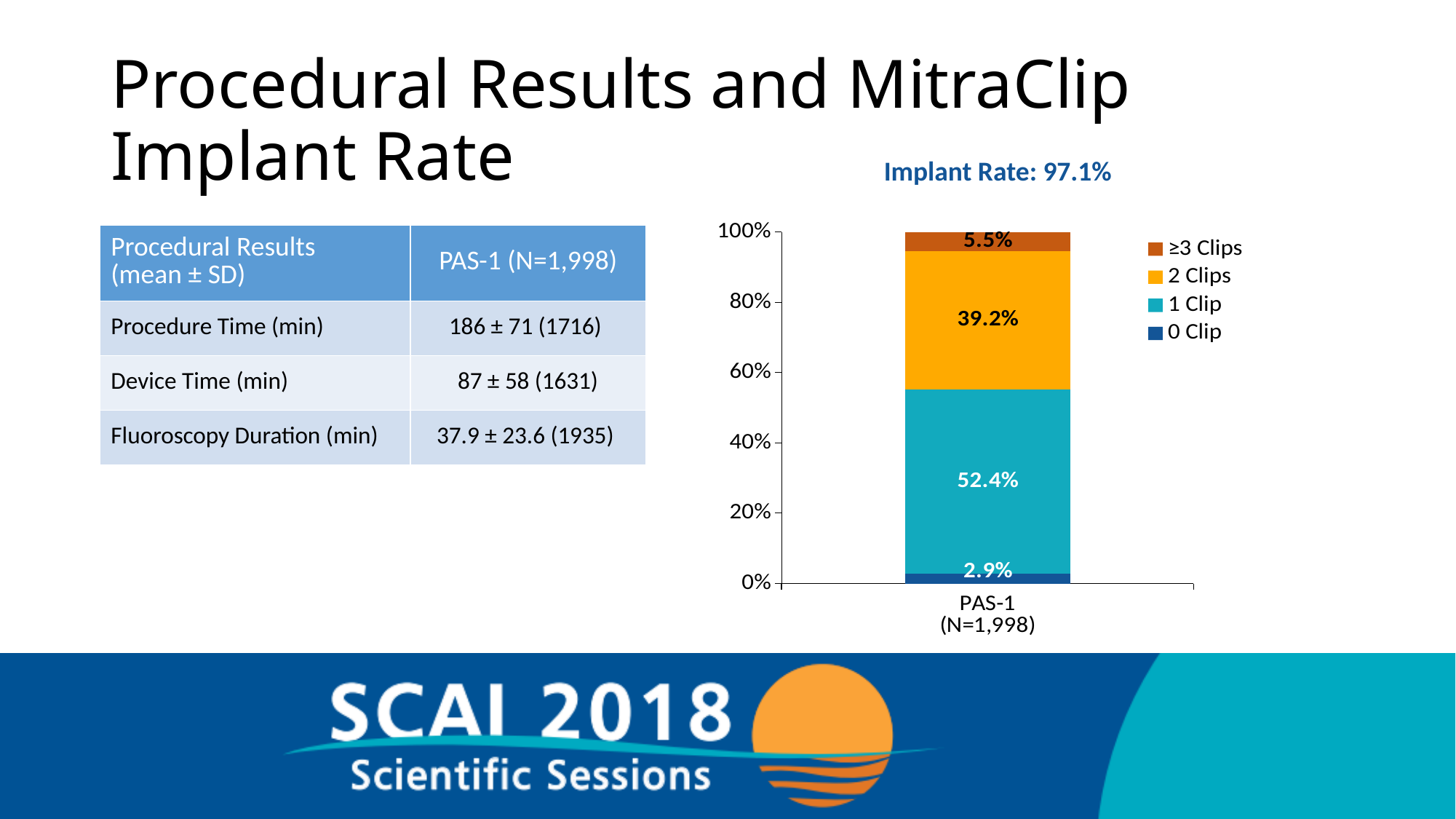
What percentage of the PAS-1 bar corresponds to 1 Clip? 52.4% Which clip category has the smallest share of the PAS-1 bar? 0 Clip Which segment is larger, 2 Clips or ≥3 Clips? 2 Clips Which clip category has the largest share of the PAS-1 bar? 1 Clip How many series does the chart legend list? 4 What kind of chart is shown on the slide? Stacked bar chart What percentage of the PAS-1 bar corresponds to 0 Clip? 2.9% What is the difference in percentage points between the 1 Clip and 2 Clips segments? 13.2 What percentage of the PAS-1 bar corresponds to ≥3 Clips? 5.5% What is the category label on the x axis of the chart? PAS-1 (N=1,998) What percentage of the PAS-1 bar corresponds to 2 Clips? 39.2% What is the implant rate stated above the chart? 97.1%